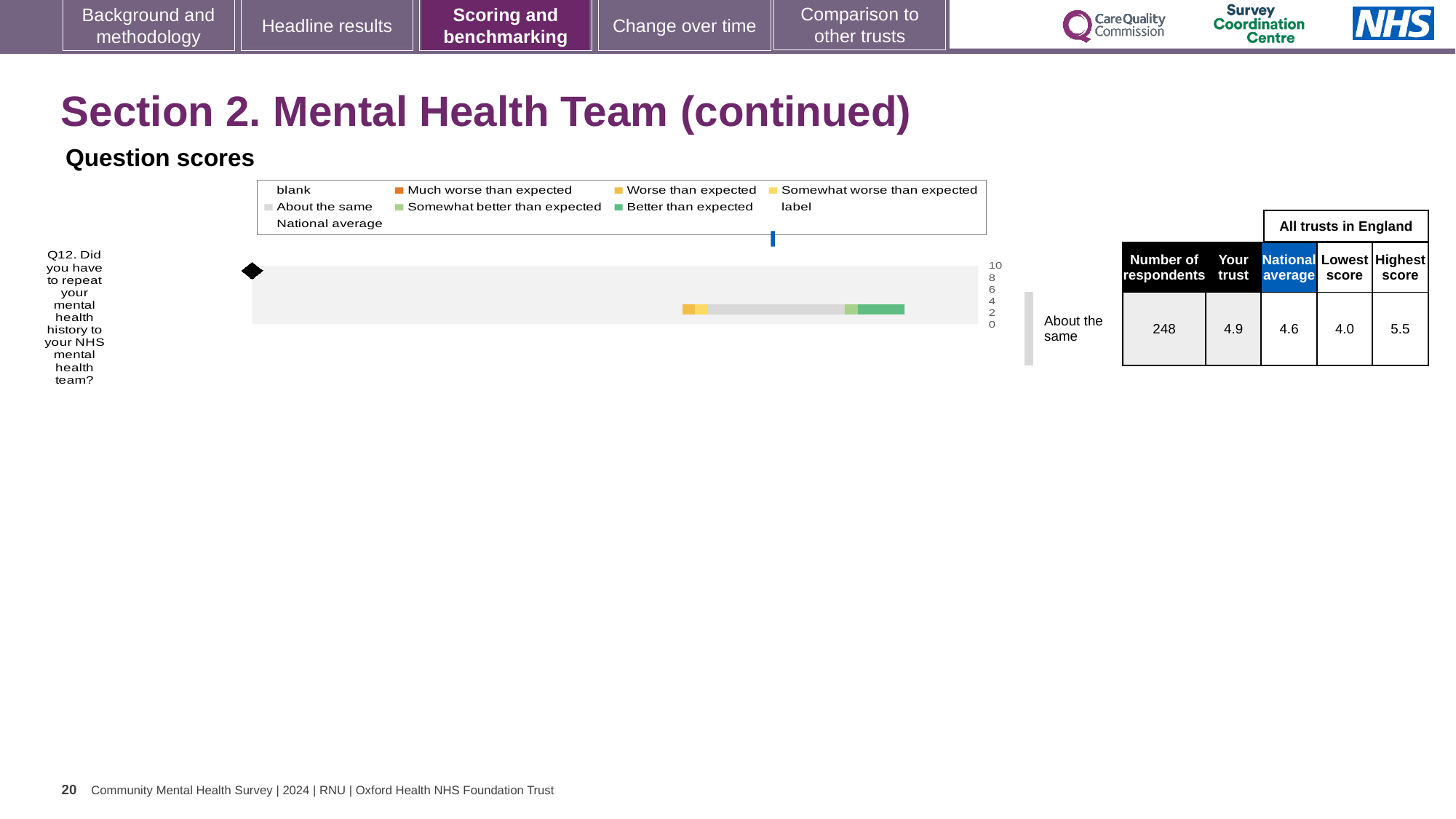
What is the difference between the highest and lowest scores among all trusts in England for Q12? 1.5 What is the highest score among all trusts in England for Q12? 5.5 What kind of chart is shown on the slide? bar chart What category is the trust's result for Q12 placed in, according to the label next to the chart? About the same What is the 'Your trust' score for Q12 in the table beside the chart? 4.9 What is the difference between the 'Your trust' score and the national average for Q12? 0.3 Which is larger for Q12, the 'Your trust' score or the national average? Your trust What is the lowest score among all trusts in England for Q12? 4.0 How many respondents answered Q12? 248 What colour does the legend use for 'Much worse than expected'? orange Which survey question does the chart on the slide relate to? Q12. Did you have to repeat your mental health history to your NHS mental health team? What is the national average score for Q12 in the table beside the chart? 4.6